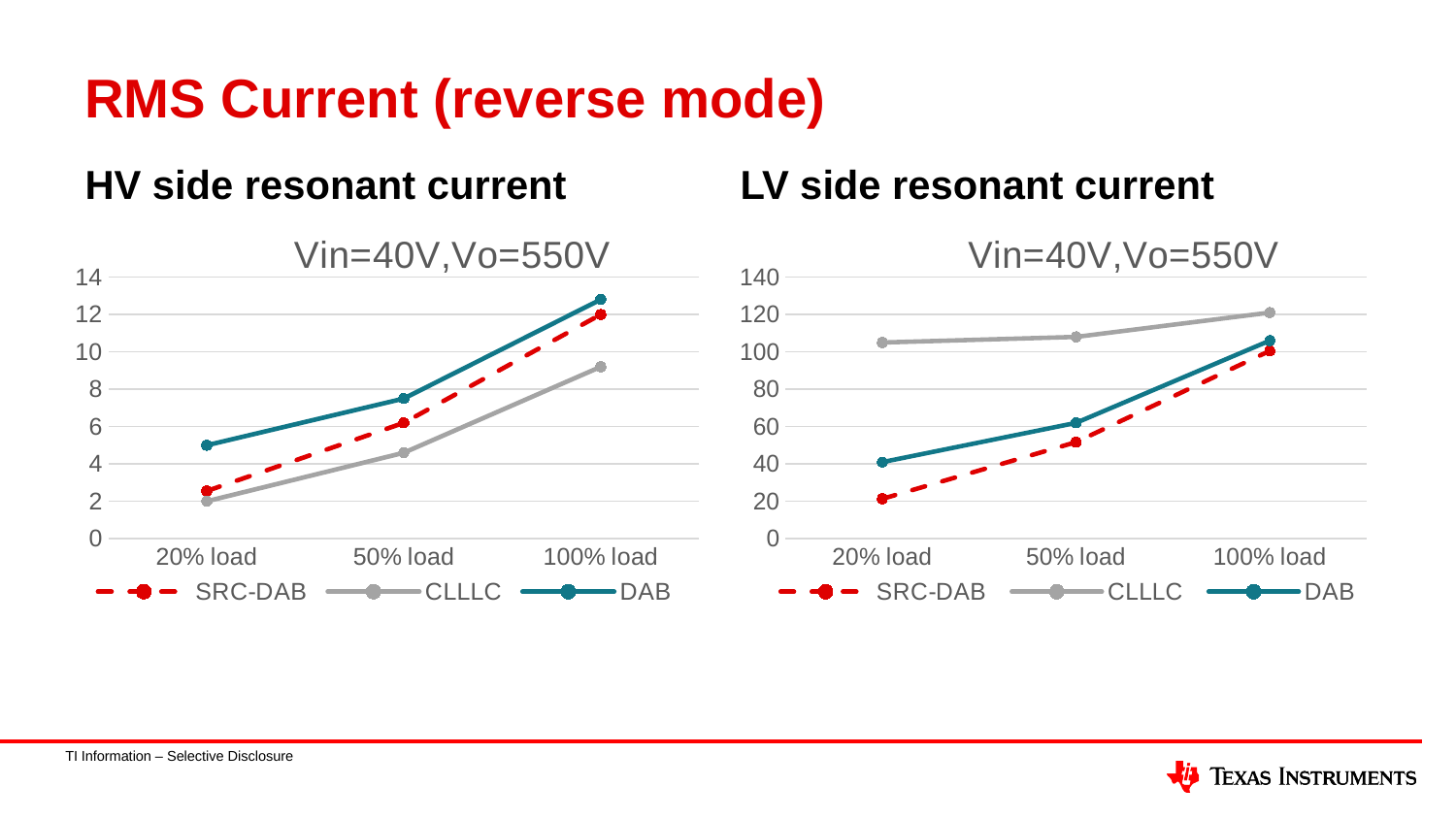
What is the title shown above the right chart (LV side resonant current)? Vin=40V,Vo=550V What kind of chart is the left chart (HV side resonant current)? line chart In the left chart (HV side resonant current), which series has the highest value at 20% load? DAB In the right chart (LV side resonant current), is the value for SRC-DAB at 20% load greater or less than 40? less In the right chart (LV side resonant current), which is larger at 50% load: CLLLC or DAB? CLLLC How many series does the legend of the right chart (LV side resonant current) list? 3 How many load categories are shown on the x axis of the left chart (HV side resonant current)? 3 In the right chart (LV side resonant current), which series has the lowest value at 20% load? SRC-DAB In the left chart (HV side resonant current), does the DAB series rise or fall from 20% load to 100% load? rise In the left chart (HV side resonant current), is the value for CLLLC at 20% load greater or less than 4? less In the left chart (HV side resonant current), is the value for DAB at 100% load greater or less than 12? greater